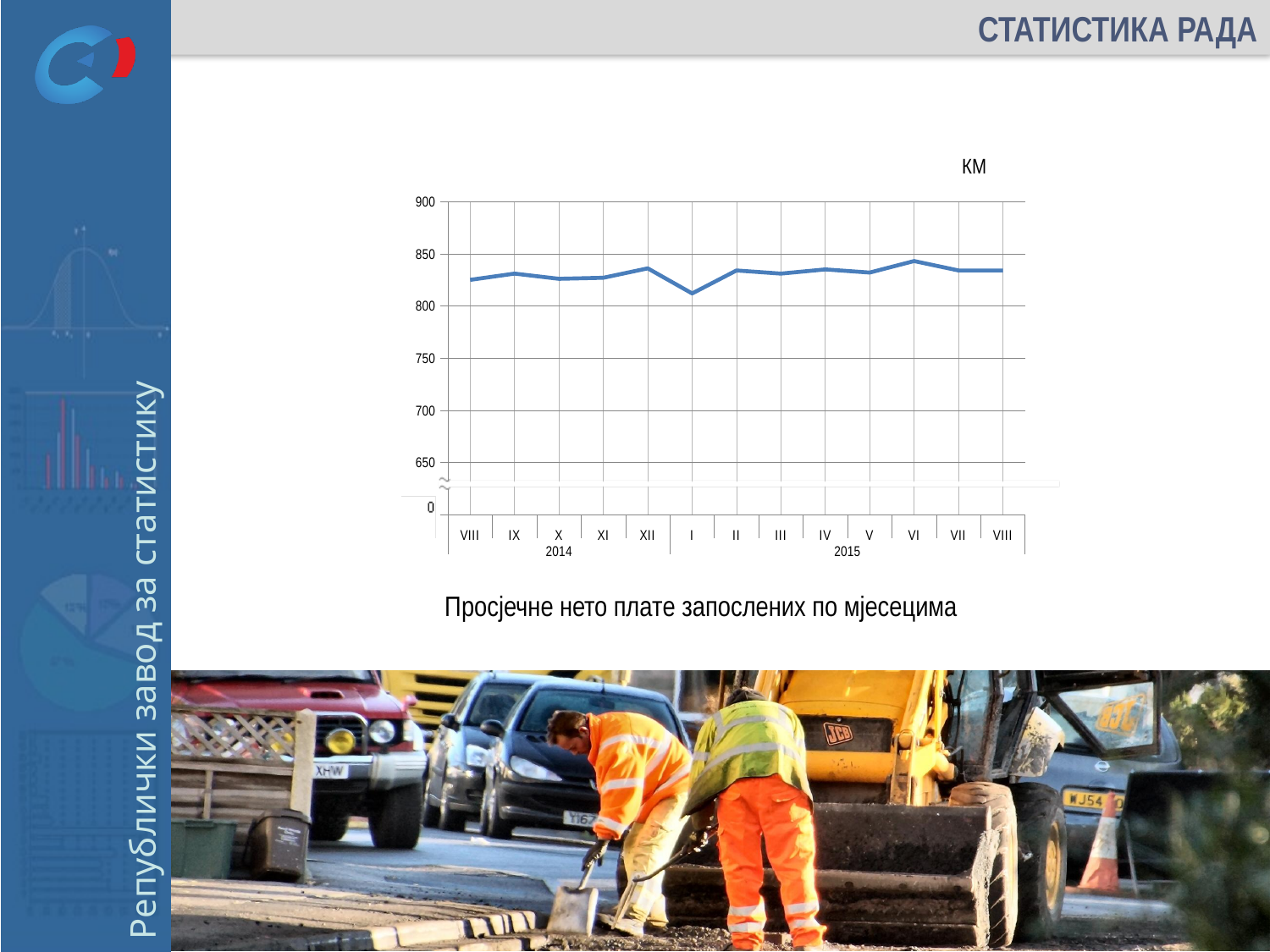
Do the values rise or fall from I 2015 to VI 2015? rise Is the value for VI 2015 greater or less than 850? less What is the caption of the chart? Просјечне нето плате запослених по мјесецима How many monthly data points are plotted on the chart? 13 What kind of chart is shown on the slide? line chart Is the value for VIII 2014 greater or less than 850? less Which is larger, the value for I 2015 or the value for VI 2015? VI 2015 Which month has the lowest average net wage on the chart? I 2015 Is the value for XII 2014 greater or less than 800? greater What unit is shown above the chart's vertical axis? КМ Which month has the highest average net wage on the chart? VI 2015